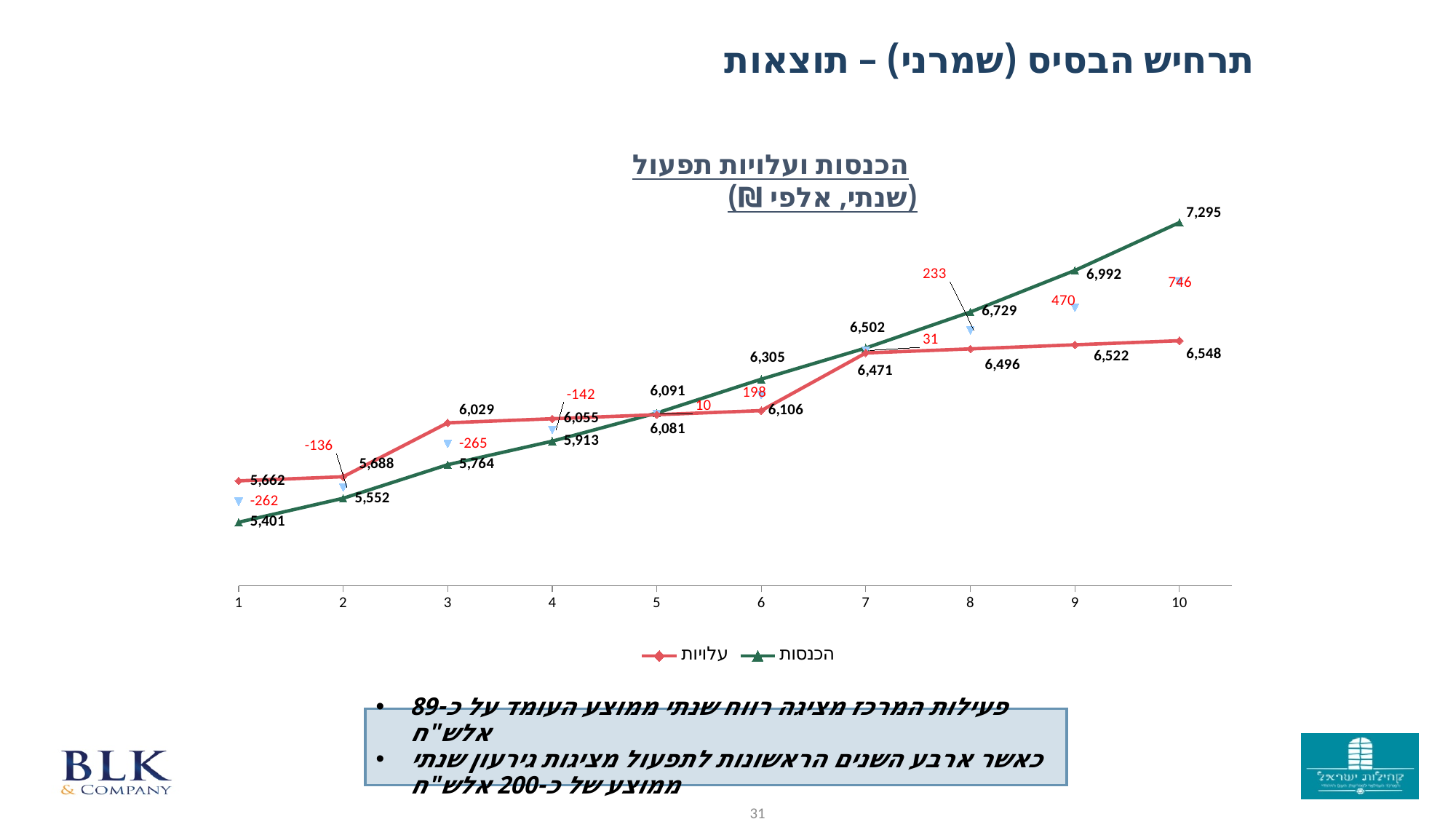
What is the difference between הכנסות and עלויות at year 10? 747 At year 9, which is larger, עלויות or הכנסות? הכנסות At year 3, which is larger, עלויות or הכנסות? עלויות What kind of chart is shown? line chart How many years are shown on the x axis? 10 At which year is הכנסות lowest? 1 What is the value of עלויות at year 7? 6,471 What is the value of עלויות at year 1? 5,662 How many series does the legend list? 2 What is the value of הכנסות at year 10? 7,295 At which year is עלויות highest? 10 What is the value of הכנסות at year 5? 6,091